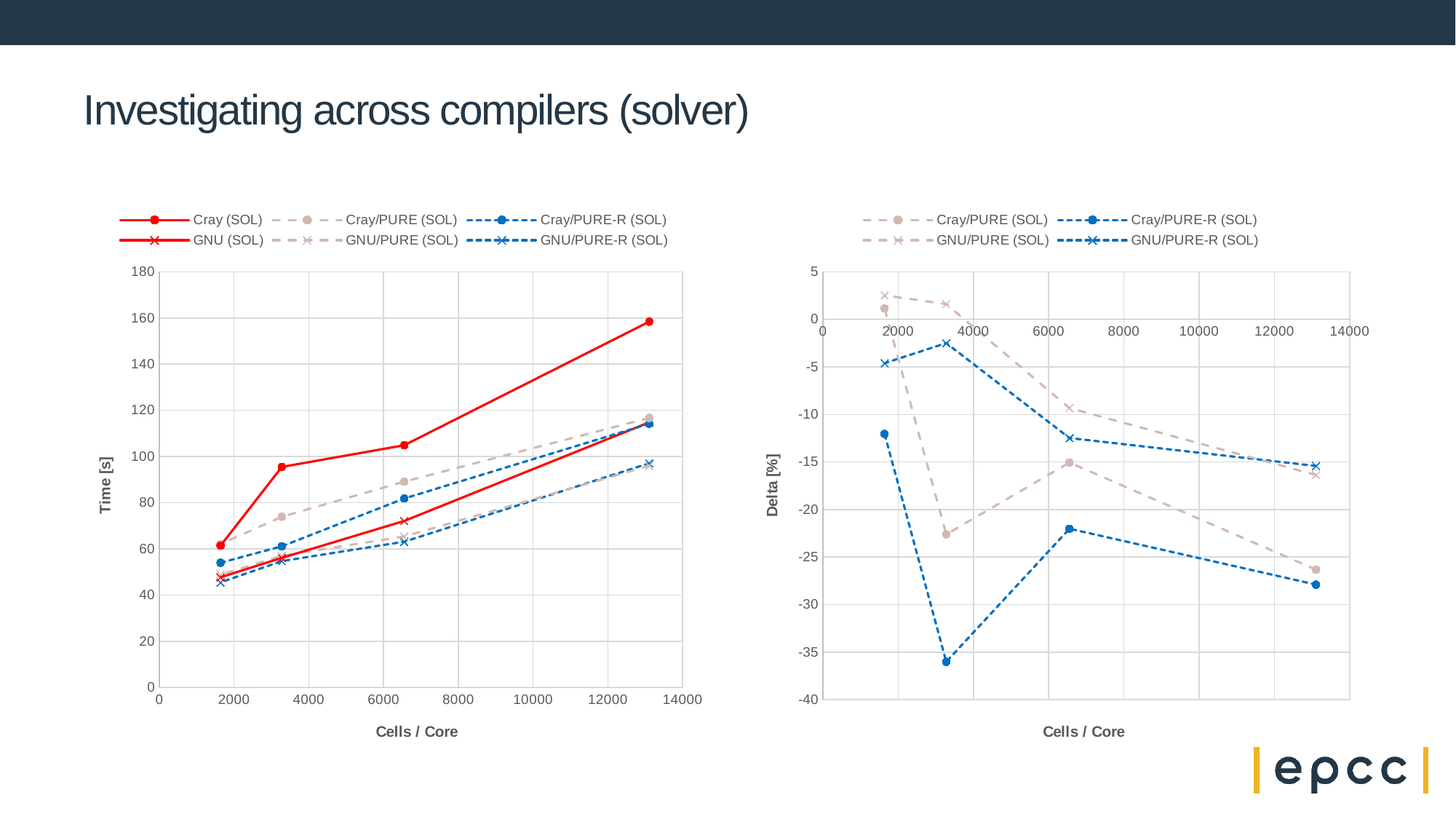
In the left chart, is the Cray/PURE-R (SOL) time at the smallest Cells / Core value greater or less than 60? less In the left chart, is the Cray (SOL) time at about 13000 Cells / Core greater or less than 140? greater In the left chart, at about 6500 Cells / Core, which is larger: Cray (SOL) or GNU (SOL)? Cray (SOL) In the left chart, how many data points does the Cray (SOL) series have? 4 In the left chart, does the time for Cray (SOL) rise or fall as Cells / Core increases? rise In the left chart, which series has the highest time at the largest Cells / Core value? Cray (SOL) In the right chart, is the Cray/PURE-R (SOL) delta at about 3300 Cells / Core greater or less than -30? less What type of chart is the left chart (Time [s] vs Cells / Core)? line chart How many series does the legend of the left chart list? 6 In the right chart, which series has the lowest Delta [%] value? Cray/PURE-R (SOL) How many series does the legend of the right chart (Delta [%]) list? 4 What is the y-axis label of the right chart? Delta [%]